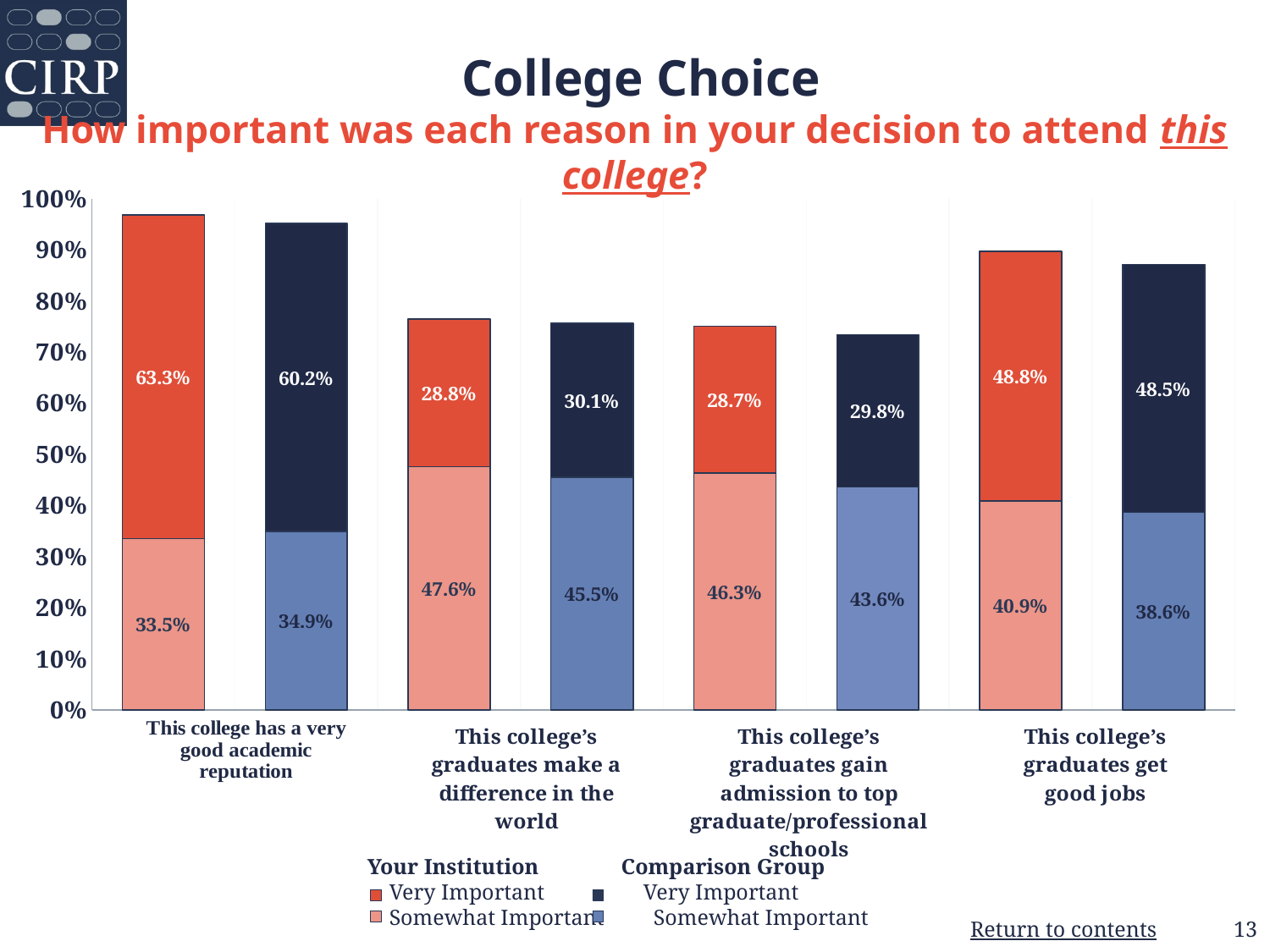
For "This college's graduates get good jobs", is the Somewhat Important percentage larger for Your Institution or the Comparison Group? Your Institution What is the combined Very Important and Somewhat Important total for Your Institution on "This college's graduates get good jobs"? 89.7% How many entries does the legend list? 4 How many reasons (categories) are shown on the x axis of the chart? 4 What percentage of the Comparison Group rated "This college's graduates get good jobs" as Somewhat Important? 38.6% What percentage of Your Institution respondents rated "This college's graduates make a difference in the world" as Somewhat Important? 47.6% Which reason has the highest Very Important percentage for Your Institution? This college has a very good academic reputation What percentage of Your Institution respondents rated "This college has a very good academic reputation" as Very Important? 63.3% Which reason has the lowest Very Important percentage for the Comparison Group? This college's graduates gain admission to top graduate/professional schools What kind of chart is shown on the slide? Stacked bar chart What is the combined Very Important and Somewhat Important total for the Comparison Group on "This college has a very good academic reputation"? 95.1% What is the difference between the Your Institution and Comparison Group Very Important percentages for "This college has a very good academic reputation"? 3.1%